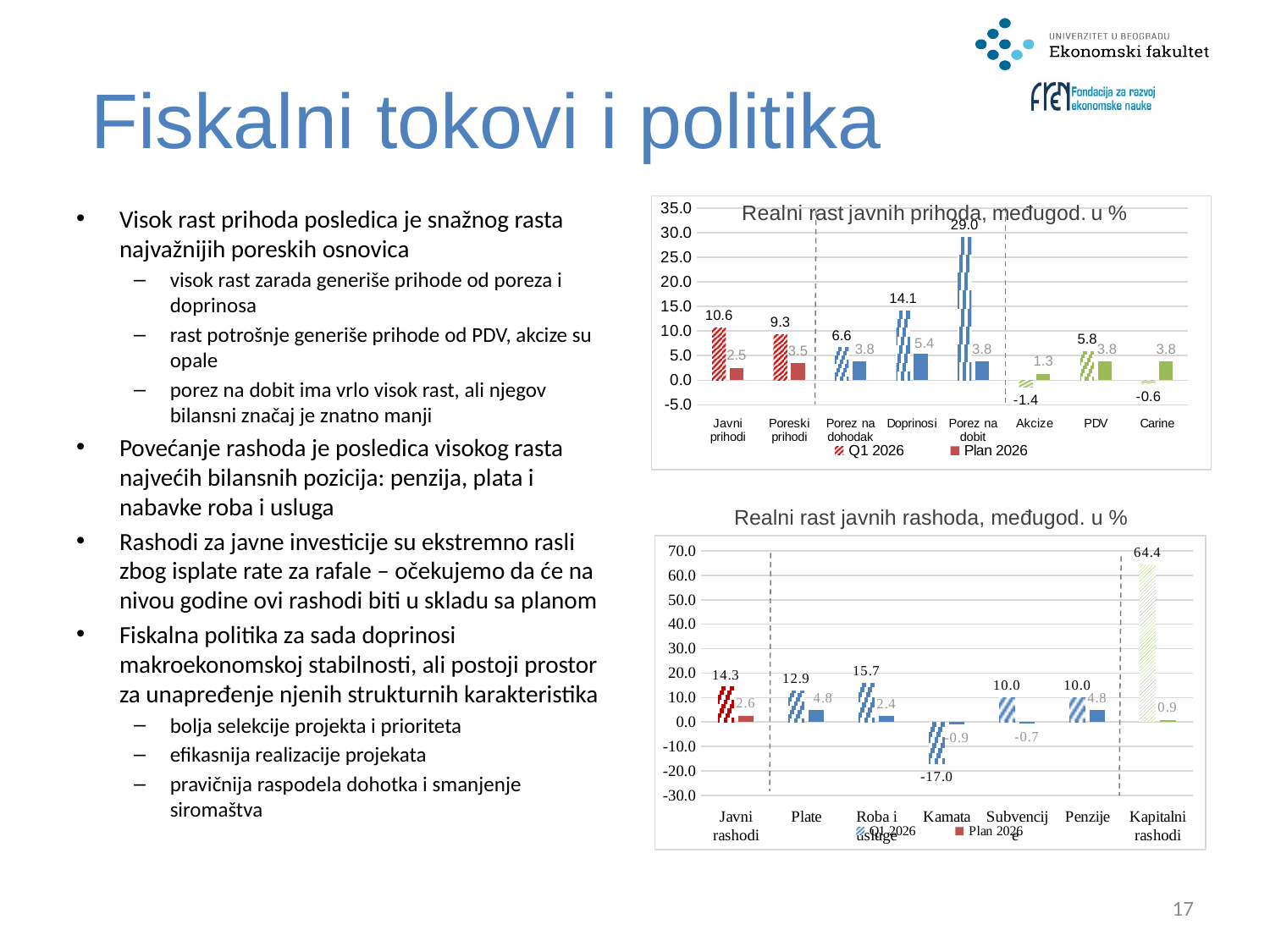
In the chart 'Realni rast javnih rashoda, međugod. u %', what is the Q1 2026 value for Kapitalni rashodi? 64.4 In the chart 'Realni rast javnih rashoda, međugod. u %', what is the difference between the Q1 2026 values for Roba i usluge and Plate? 2.8 What type of chart is the chart 'Realni rast javnih rashoda, međugod. u %'? Bar chart In the chart 'Realni rast javnih rashoda, međugod. u %', which category has the lowest Q1 2026 value? Kamata In the chart 'Realni rast javnih prihoda, međugod. u %', what is the Q1 2026 value for Porez na dobit? 29.0 In the chart 'Realni rast javnih prihoda, međugod. u %', how many categories are shown on the x axis? 8 In the chart 'Realni rast javnih prihoda, međugod. u %', what is the difference between the Q1 2026 and Plan 2026 values for Javni prihodi? 8.1 In the chart 'Realni rast javnih prihoda, međugod. u %', what is the Plan 2026 value for Doprinosi? 5.4 In the chart 'Realni rast javnih rashoda, međugod. u %', how many series does the legend list? 2 In the chart 'Realni rast javnih prihoda, međugod. u %', which is larger for PDV: the Q1 2026 value or the Plan 2026 value? Q1 2026 In the chart 'Realni rast javnih prihoda, međugod. u %', which category has the lowest Q1 2026 value? Akcize In the chart 'Realni rast javnih rashoda, međugod. u %', what is the Plan 2026 value for Subvencije? -0.7